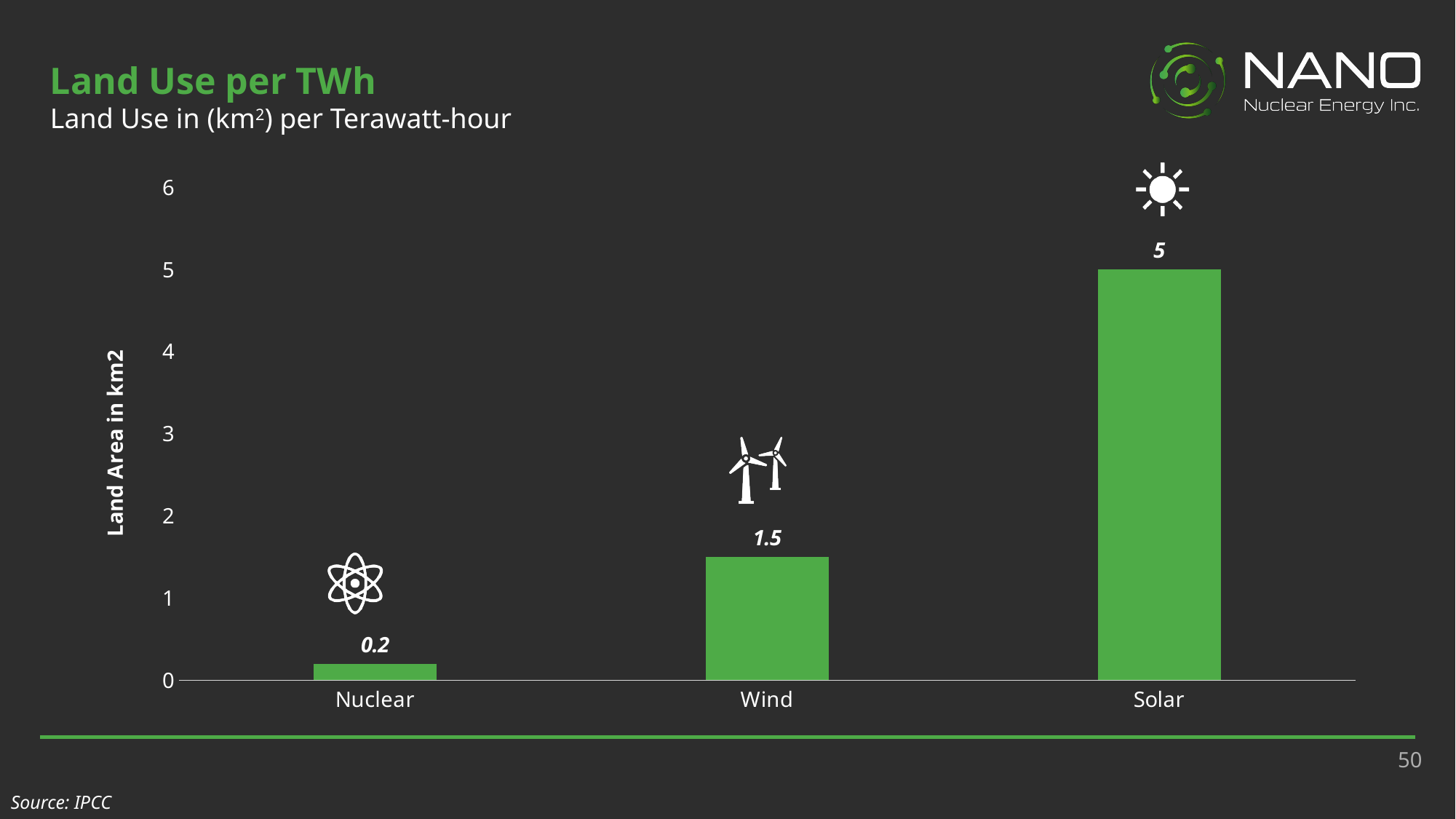
How many energy sources are shown on the chart? 3 Which energy source has the highest land use per TWh? Solar What is the land use value for Wind? 1.5 What is the land use value for Nuclear? 0.2 Which has a larger land use value, Wind or Nuclear? Wind What is the difference in land use between Wind and Nuclear? 1.3 What is the label of the vertical axis? Land Area in km2 Which energy source has the lowest land use per TWh? Nuclear Is the value for Solar greater or less than 4? greater What kind of chart is shown on the slide? Bar chart What is the difference in land use between Solar and Wind? 3.5 What is the land use value for Solar? 5